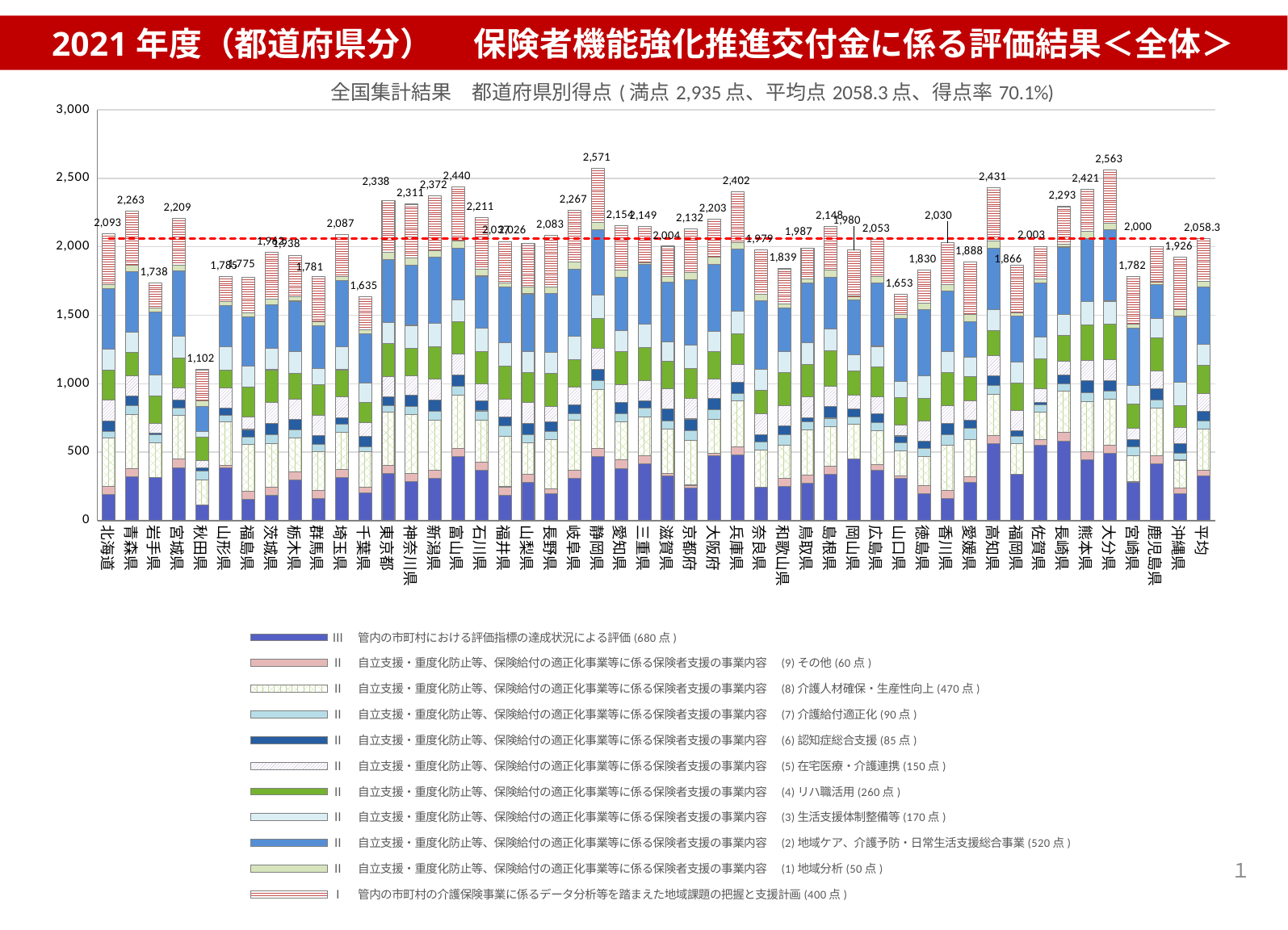
What is the total score for 静岡県? 2,571 What is the difference between the total scores of 静岡県 and 秋田県? 1,469 How many series does the legend list? 11 Which prefecture has the lowest total score? 秋田県 According to the chart title, what is the full score (満点)? 2,935 点 What kind of chart is shown on the slide? Stacked bar chart Which prefecture has the highest total score? 静岡県 What is the total score for 秋田県? 1,102 Is the total score for 千葉県 greater or less than 2,000? less What is the total score for 大分県? 2,563 Which has a higher total score, 東京都 or 大阪府? 東京都 What is the value shown for 平均 (the average bar)? 2,058.3